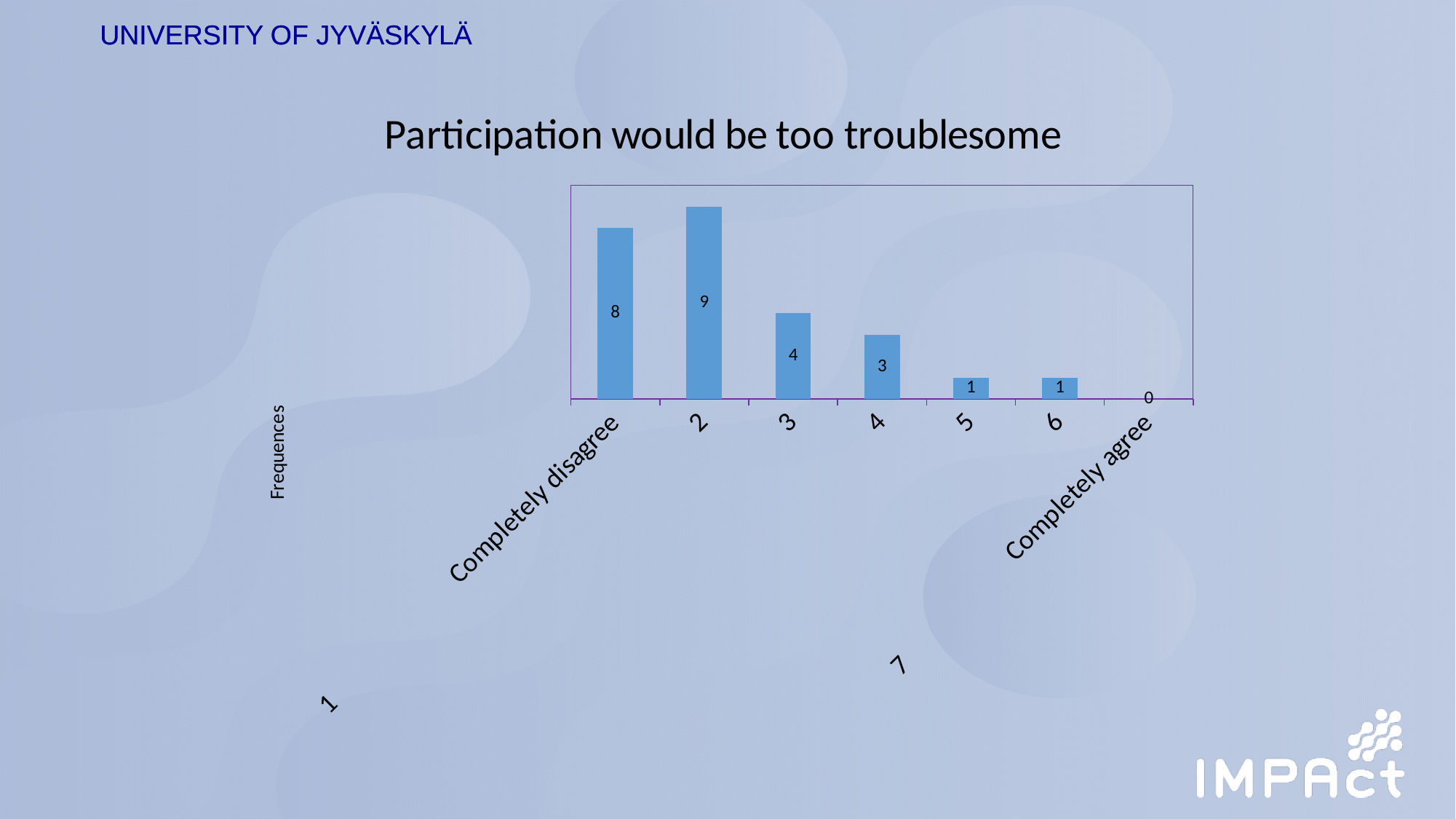
Which is larger, the value for "Completely disagree" or the value for "3"? Completely disagree What kind of chart is shown on the slide? Bar chart How many categories are shown on the x axis? 7 Which category has the lowest value? Completely agree Do the values generally rise or fall from category "2" to "Completely agree"? Fall What is the value for "Completely agree"? 0 What is the value for the category "2"? 9 What is the value for the category "4"? 3 What is the value for "Completely disagree"? 8 Which category has the highest value? 2 What is the difference between the values for "2" and "3"? 5 What is the title of the chart? Participation would be too troublesome